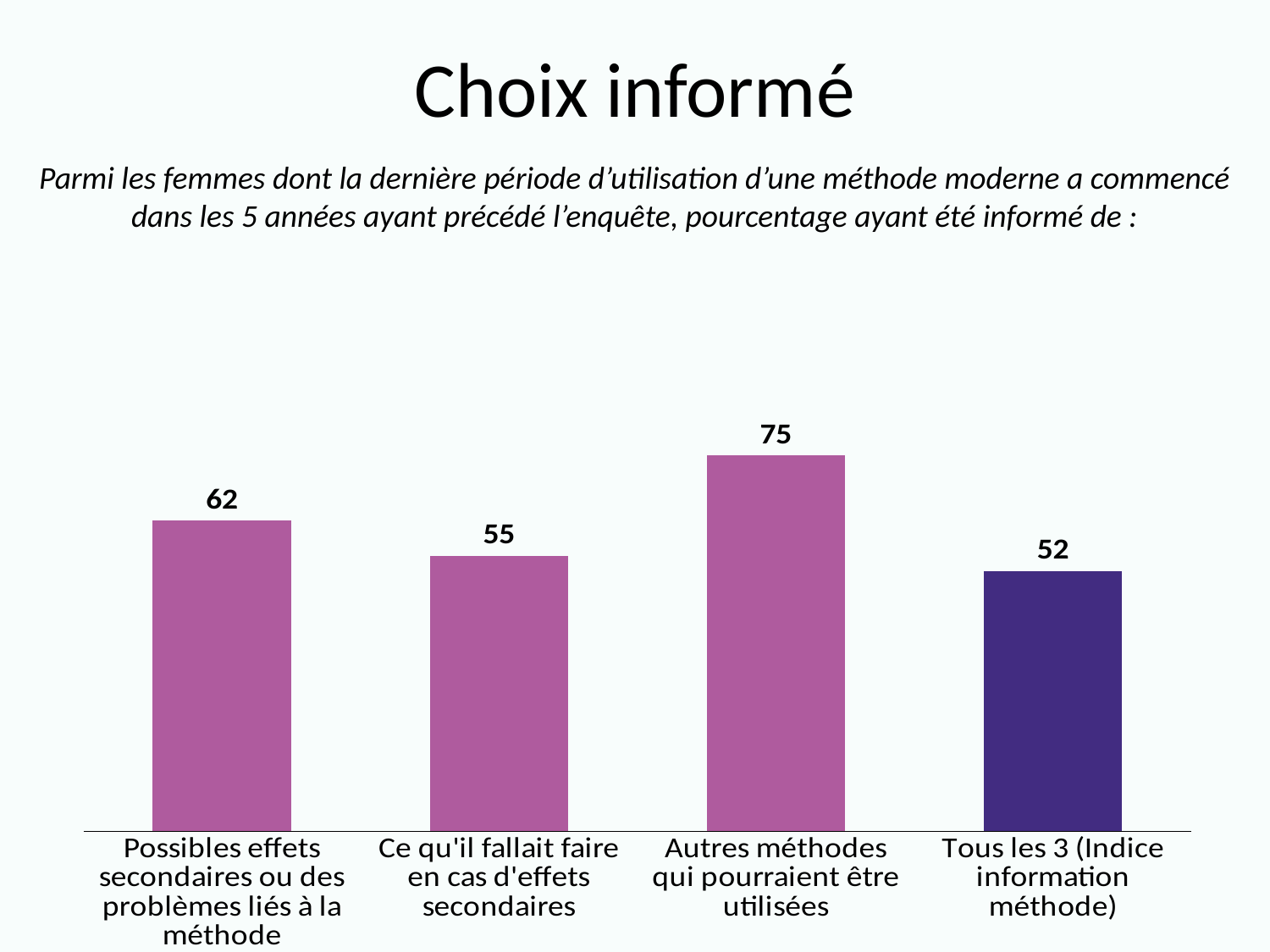
What is the value for 'Autres méthodes qui pourraient être utilisées'? 75 Which is larger: the value for 'Possibles effets secondaires ou des problèmes liés à la méthode' or for 'Ce qu'il fallait faire en cas d'effets secondaires'? Possibles effets secondaires ou des problèmes liés à la méthode What is the value for 'Ce qu'il fallait faire en cas d'effets secondaires'? 55 Which category has the highest value? Autres méthodes qui pourraient être utilisées What is the difference between the values for 'Possibles effets secondaires ou des problèmes liés à la méthode' and 'Ce qu'il fallait faire en cas d'effets secondaires'? 7 What is the difference between the values for 'Autres méthodes qui pourraient être utilisées' and 'Tous les 3 (Indice information méthode)'? 23 What is the value for 'Possibles effets secondaires ou des problèmes liés à la méthode'? 62 What is the value for 'Tous les 3 (Indice information méthode)'? 52 What kind of chart is shown on the slide? Bar chart How many categories are shown in the chart? 4 Which category has the lowest value? Tous les 3 (Indice information méthode) What is the title of the slide? Choix informé